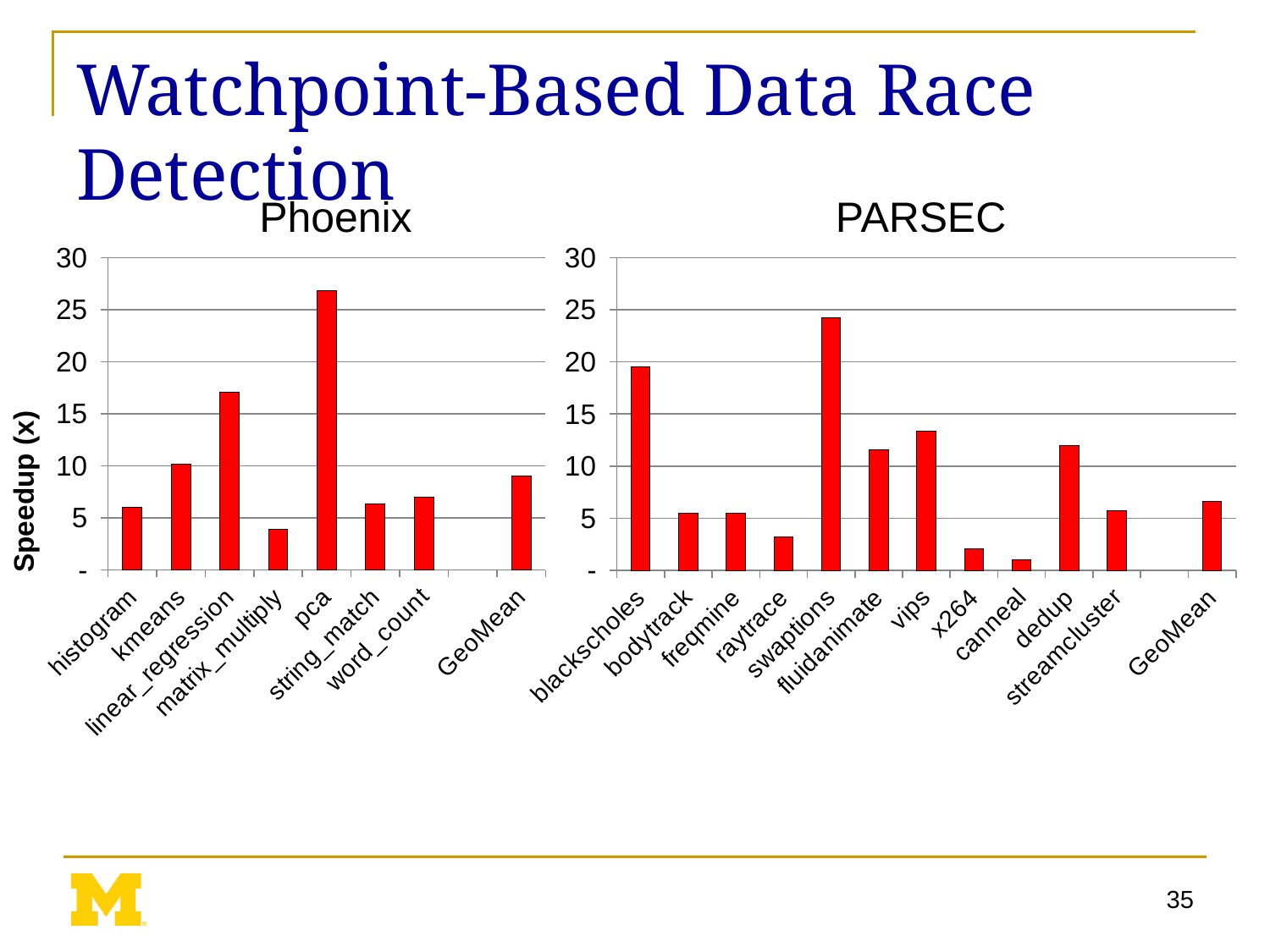
In the Phoenix chart, which category has the lowest speedup? matrix_multiply In the PARSEC chart, is the value for raytrace greater or less than 5? less In the PARSEC chart, which category has the lowest speedup? canneal How many bars are shown in the PARSEC chart? 12 How many bars are shown in the Phoenix chart? 8 In the Phoenix chart, is the value for linear_regression greater or less than 15? greater In the Phoenix chart, which is larger, the value for kmeans or the value for histogram? kmeans In the Phoenix chart, which category has the highest speedup? pca In the PARSEC chart, is the value for blackscholes greater or less than 15? greater In the PARSEC chart, which is larger, the value for dedup or the value for raytrace? dedup In the PARSEC chart, which category has the highest speedup? swaptions What is the y-axis label shared by the charts on the slide? Speedup (x)